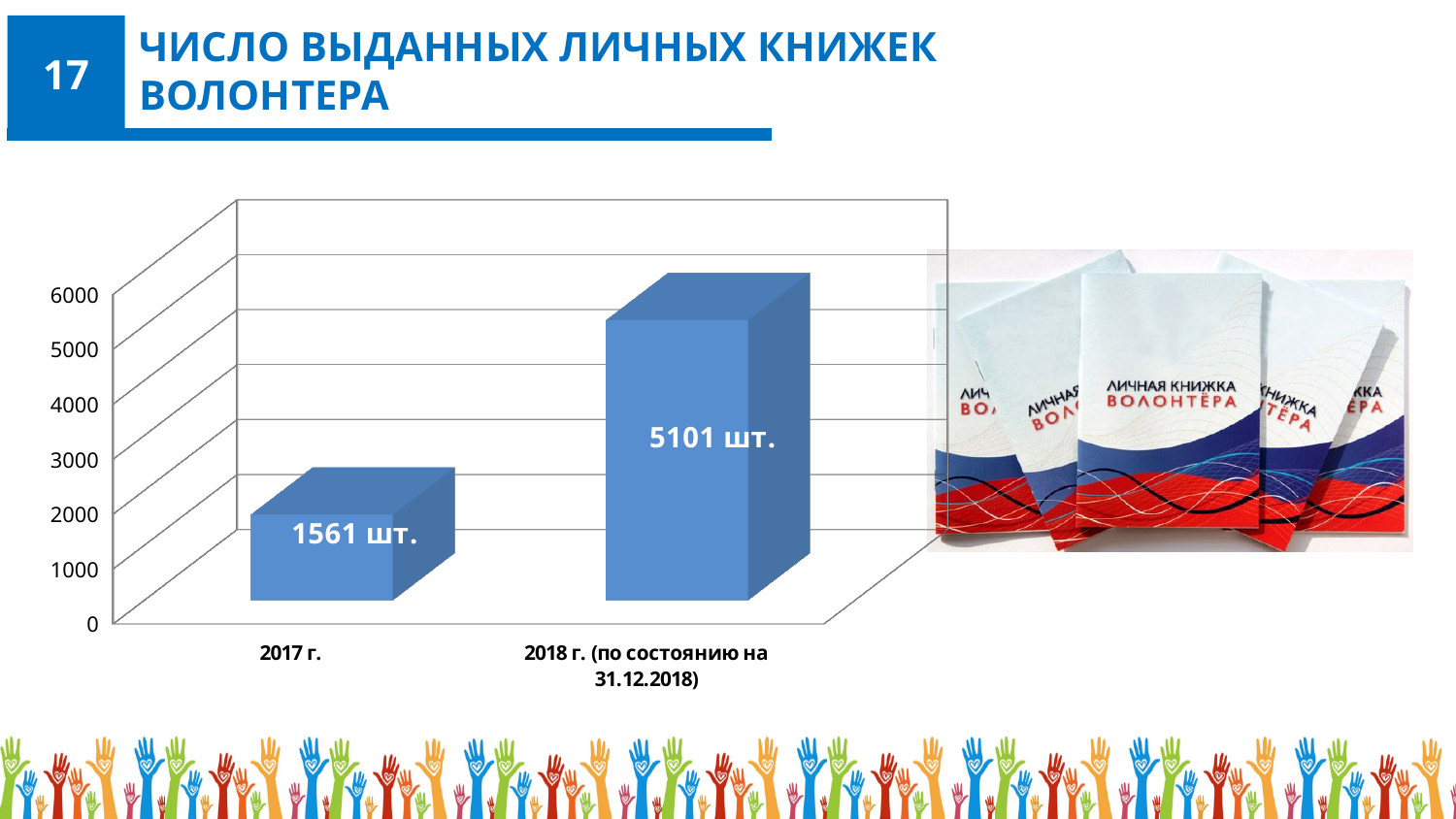
What is the title of the slide containing the chart? ЧИСЛО ВЫДАННЫХ ЛИЧНЫХ КНИЖЕК ВОЛОНТЕРА What is the value for 2018 г. (по состоянию на 31.12.2018)? 5101 шт. What is the difference between the 2018 value and the 2017 value? 3540 шт. Is the value for 2018 г. greater or less than 5000? greater How many categories are shown on the x axis? 2 Which category has the lowest value? 2017 г. What is the value for 2017 г.? 1561 шт. Do the values rise or fall from 2017 to 2018? rise Which is larger, the value for 2017 г. or the value for 2018 г.? 2018 г. Is the value for 2017 г. greater or less than 2000? less Which category has the highest value? 2018 г. (по состоянию на 31.12.2018) What kind of chart is shown on the slide? bar chart